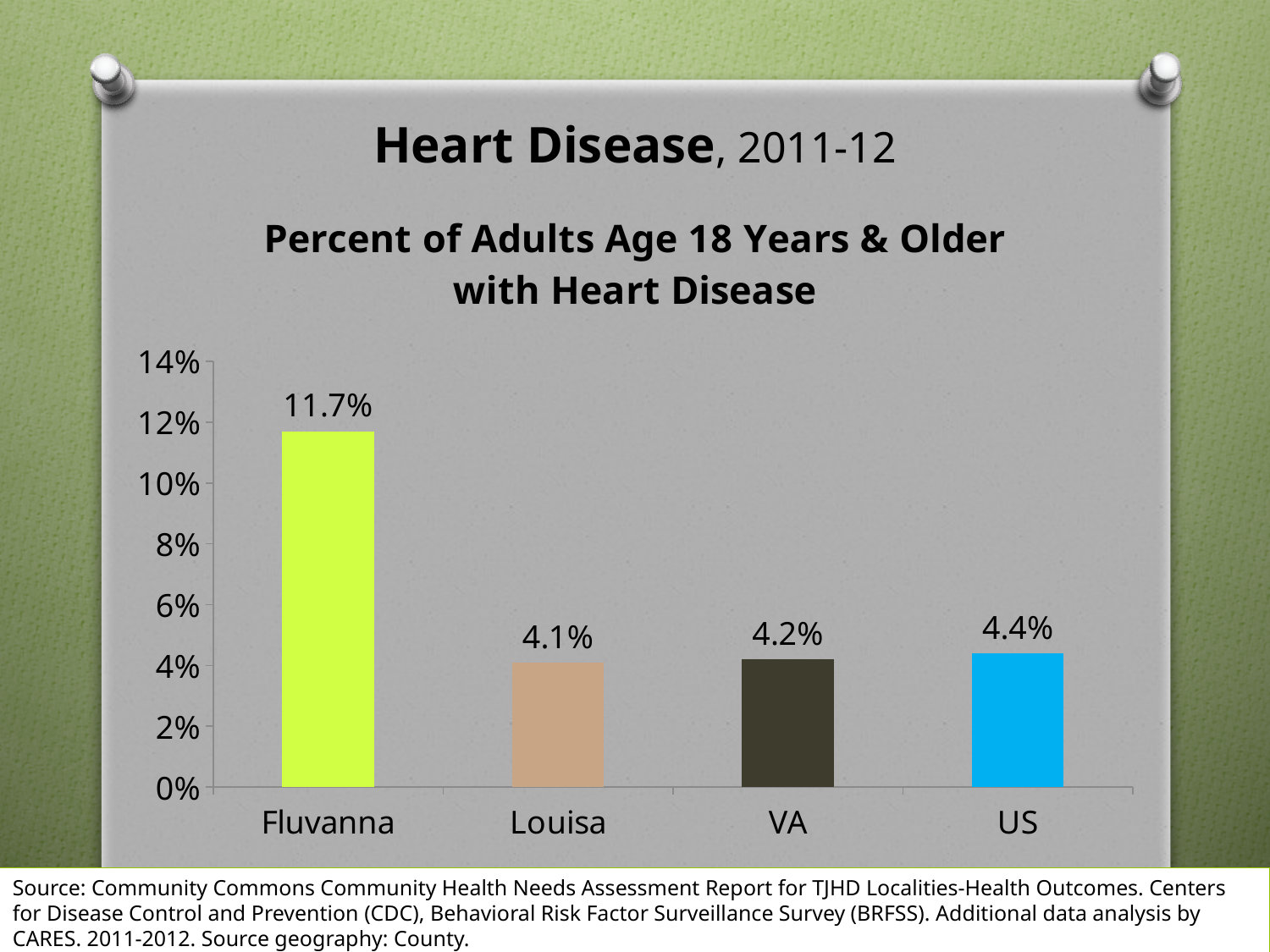
What is the difference between the values for US and Louisa? 0.3% What is the value for VA? 4.2% Is the value for Fluvanna greater or less than 10%? greater What is the value for Fluvanna? 11.7% Which category has the lowest value? Louisa What kind of chart is shown on the slide? bar chart Which category has the highest value? Fluvanna Which is larger, the value for Fluvanna or the value for VA? Fluvanna What is the difference between the values for Fluvanna and US? 7.3% What is the value for US? 4.4% How many categories are shown on the x axis? 4 What is the value for Louisa? 4.1%